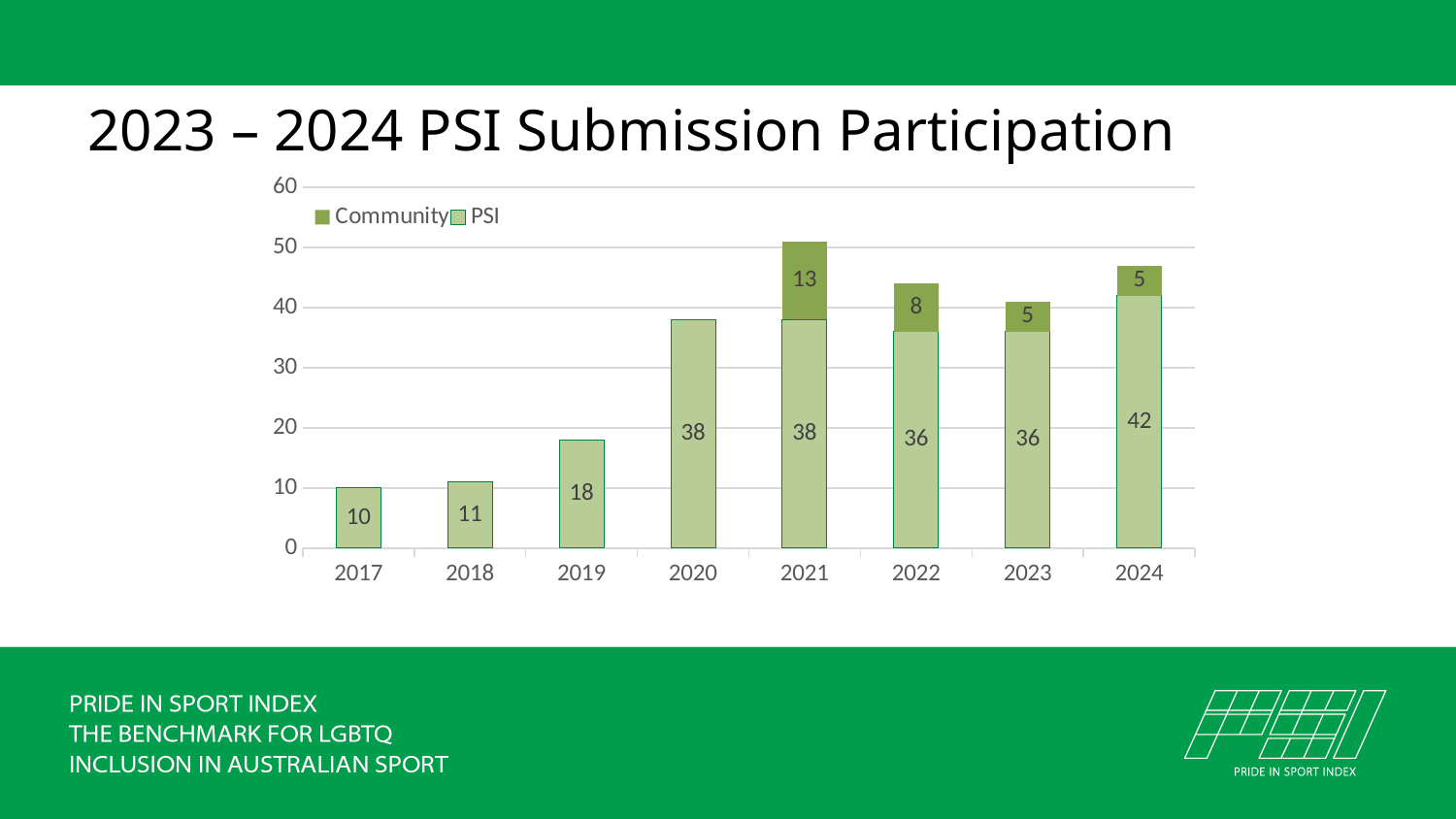
What kind of chart is shown on the slide? Stacked bar chart What is the PSI value for 2020? 38 How many series does the legend list? 2 What is the Community value for 2021? 13 How many years are shown on the x axis? 8 What is the PSI value for 2024? 42 Which year has the highest PSI value? 2024 Is the Community value larger in 2021 or in 2023? 2021 What is the total of the stacked bar for 2021? 51 Which year has the lowest PSI value? 2017 What is the total of the stacked bar for 2022? 44 What is the difference between the PSI values for 2019 and 2018? 7